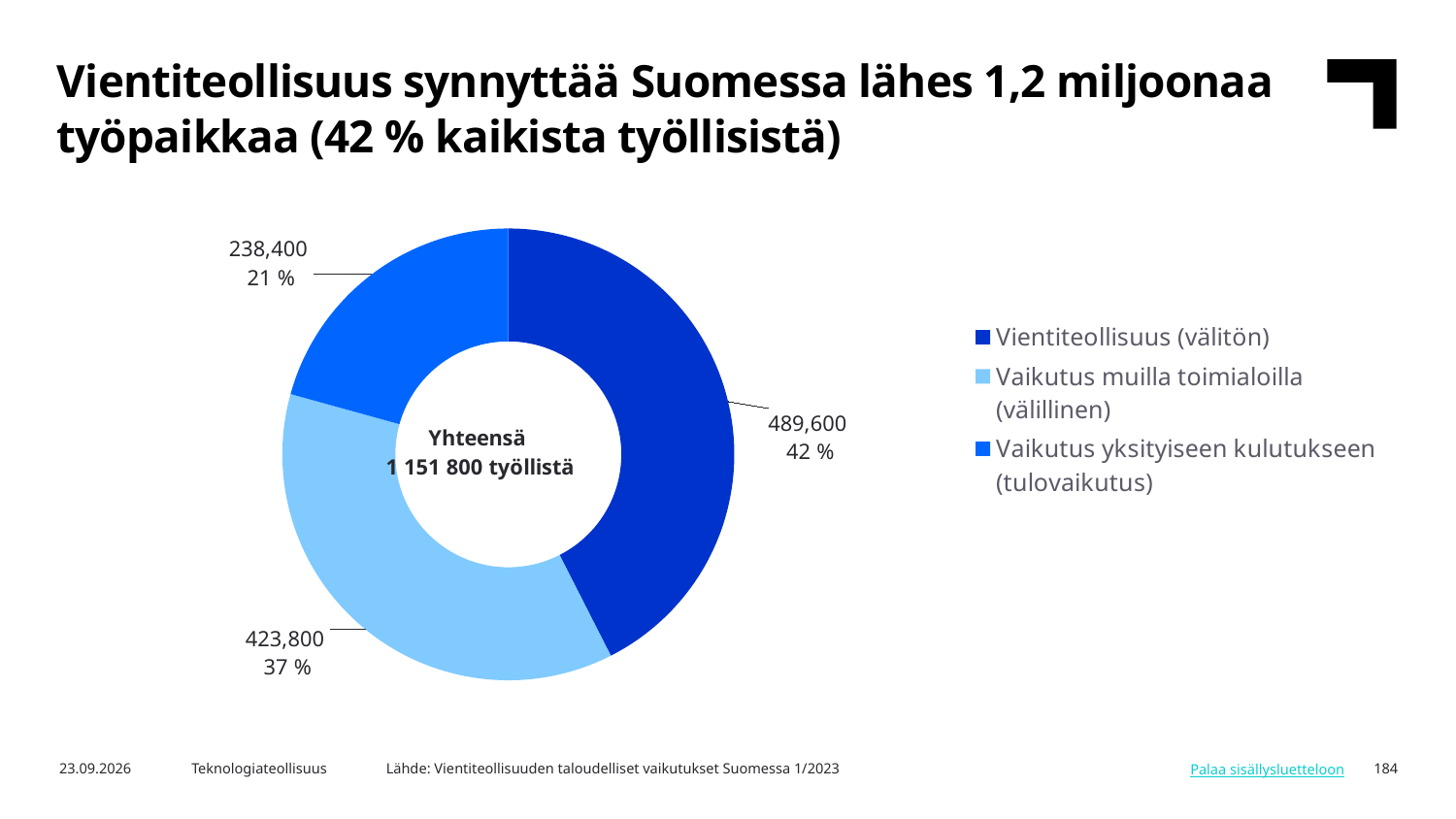
What share of the donut does Vaikutus yksityiseen kulutukseen (tulovaikutus) represent? 21 % Which category has the largest slice? Vientiteollisuus (välitön) What share of the donut does Vientiteollisuus (välitön) represent? 42 % What is the difference between the values for Vientiteollisuus (välitön) and Vaikutus muilla toimialoilla (välillinen)? 65,800 What total is shown in the centre of the donut chart? 1 151 800 työllistä What kind of chart is shown on the slide? Donut (pie) chart How many slices does the donut chart have? 3 What is the value for Vaikutus yksityiseen kulutukseen (tulovaikutus)? 238,400 What is the value for Vientiteollisuus (välitön)? 489,600 What is the value for Vaikutus muilla toimialoilla (välillinen)? 423,800 How many entries does the legend list? 3 Which category has the smallest slice? Vaikutus yksityiseen kulutukseen (tulovaikutus)